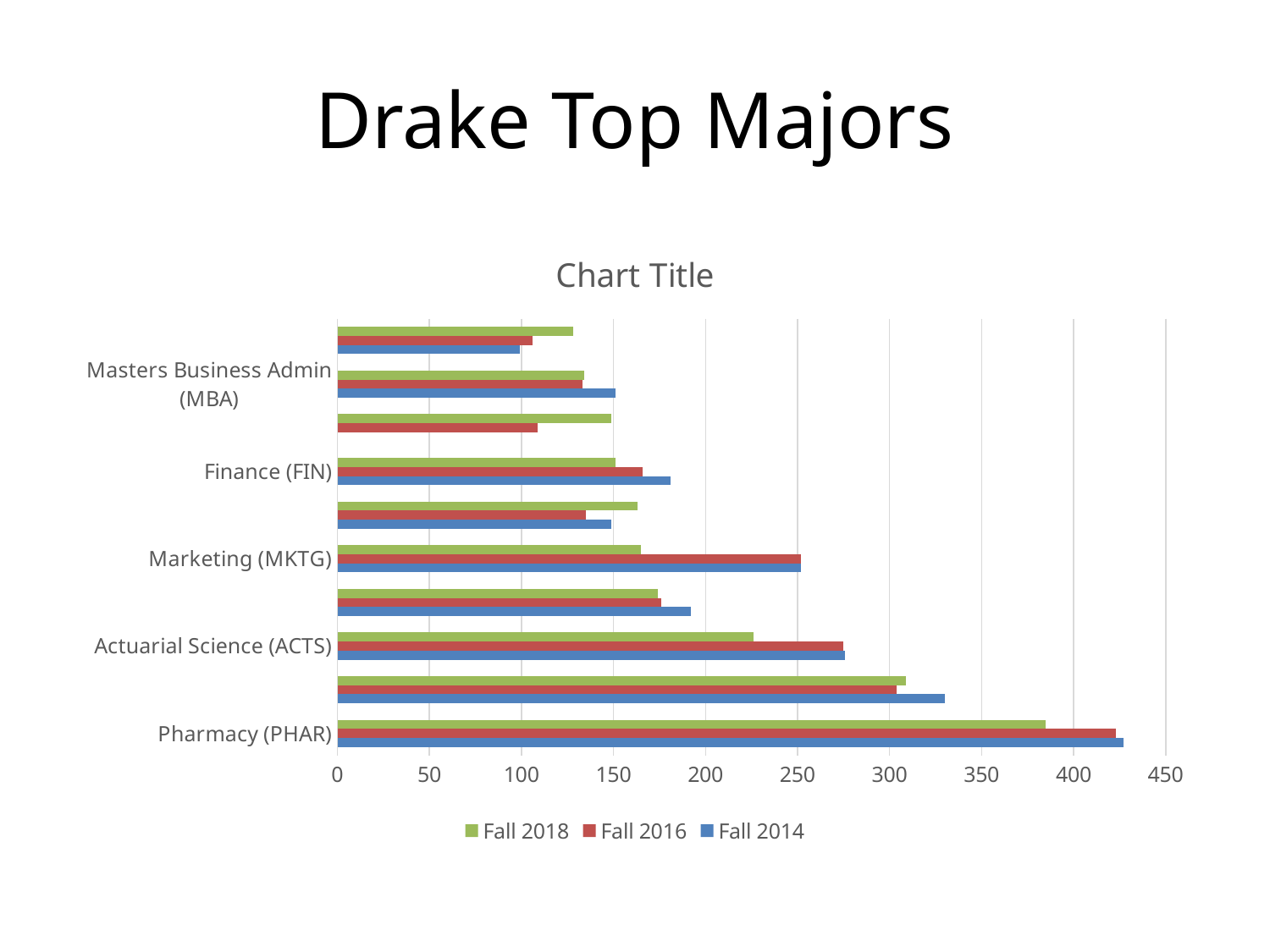
Is the Fall 2018 value for Actuarial Science (ACTS) greater or less than 250? less Which major has the highest Fall 2014 value? Pharmacy (PHAR) What are the series names listed in the legend? Fall 2018, Fall 2016, Fall 2014 How many series does the legend list? 3 Is the Fall 2018 value for Marketing (MKTG) greater or less than 200? less Is the Fall 2014 value for Masters Business Admin (MBA) greater or less than 200? less What is the title printed above the chart? Chart Title For Finance (FIN), which is larger: the Fall 2014 value or the Fall 2018 value? Fall 2014 What kind of chart is shown on the slide? Bar chart For Marketing (MKTG), which is larger: the Fall 2016 value or the Fall 2018 value? Fall 2016